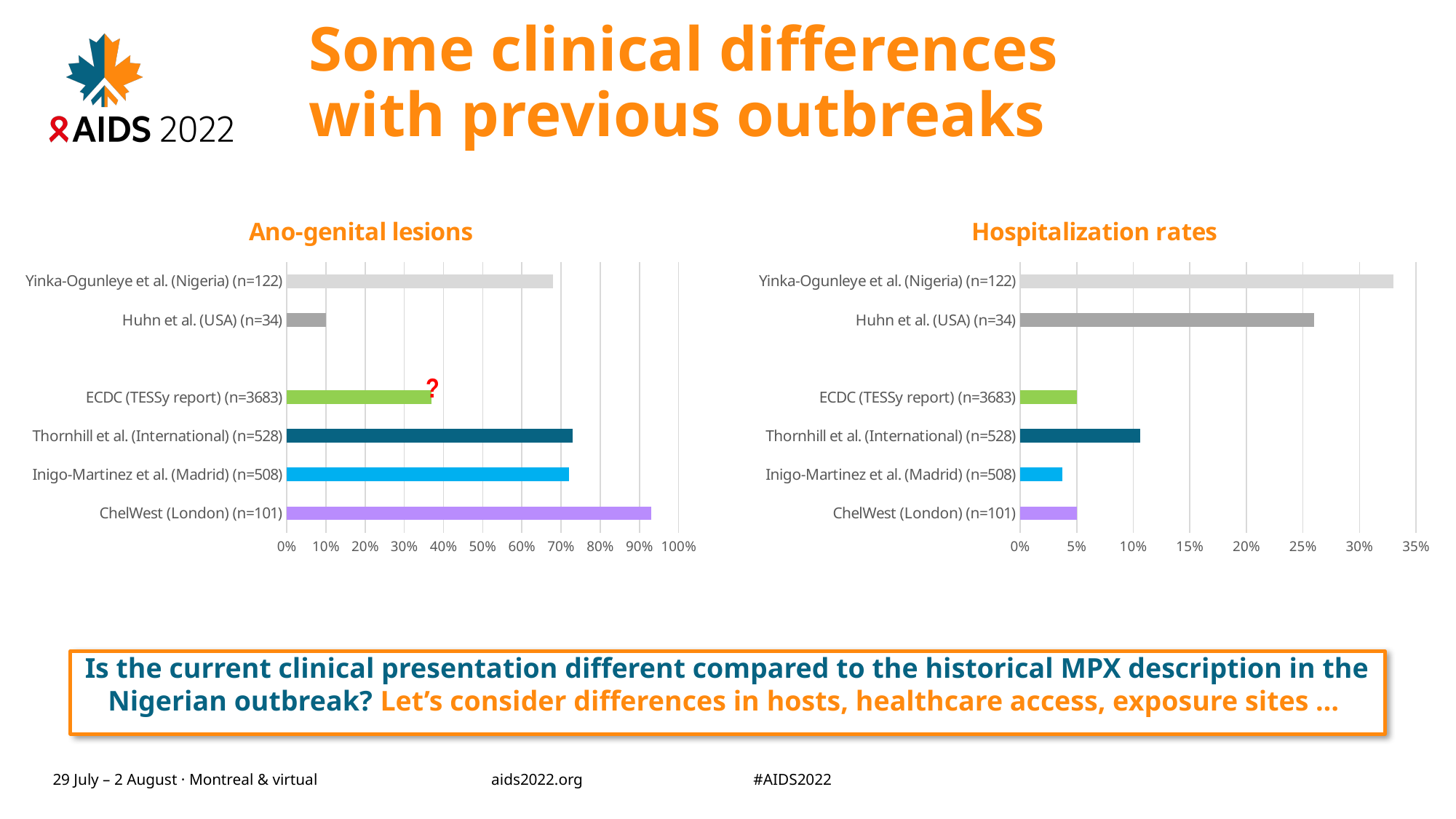
In the 'Ano-genital lesions' chart, is the value for ECDC (TESSy report) greater or less than 40%? less In the 'Ano-genital lesions' chart, which is larger: the value for Yinka-Ogunleye et al. (Nigeria) or for ChelWest (London)? ChelWest (London) How many studies are plotted in the 'Hospitalization rates' chart? 6 In the 'Hospitalization rates' chart, which is larger: the value for Huhn et al. (USA) or for Yinka-Ogunleye et al. (Nigeria)? Yinka-Ogunleye et al. (Nigeria) In the 'Hospitalization rates' chart, which study has the highest value? Yinka-Ogunleye et al. (Nigeria) (n=122) What kind of chart is the 'Ano-genital lesions' chart? Bar chart In the 'Ano-genital lesions' chart, is the value for ChelWest (London) greater or less than 90%? greater In the 'Hospitalization rates' chart, is the value for Thornhill et al. (International) greater or less than 15%? less In the 'Ano-genital lesions' chart, which study has the highest value? ChelWest (London) (n=101) In the 'Ano-genital lesions' chart, which study has the lowest value? Huhn et al. (USA) (n=34) What is the title of the chart on the right side of the slide? Hospitalization rates